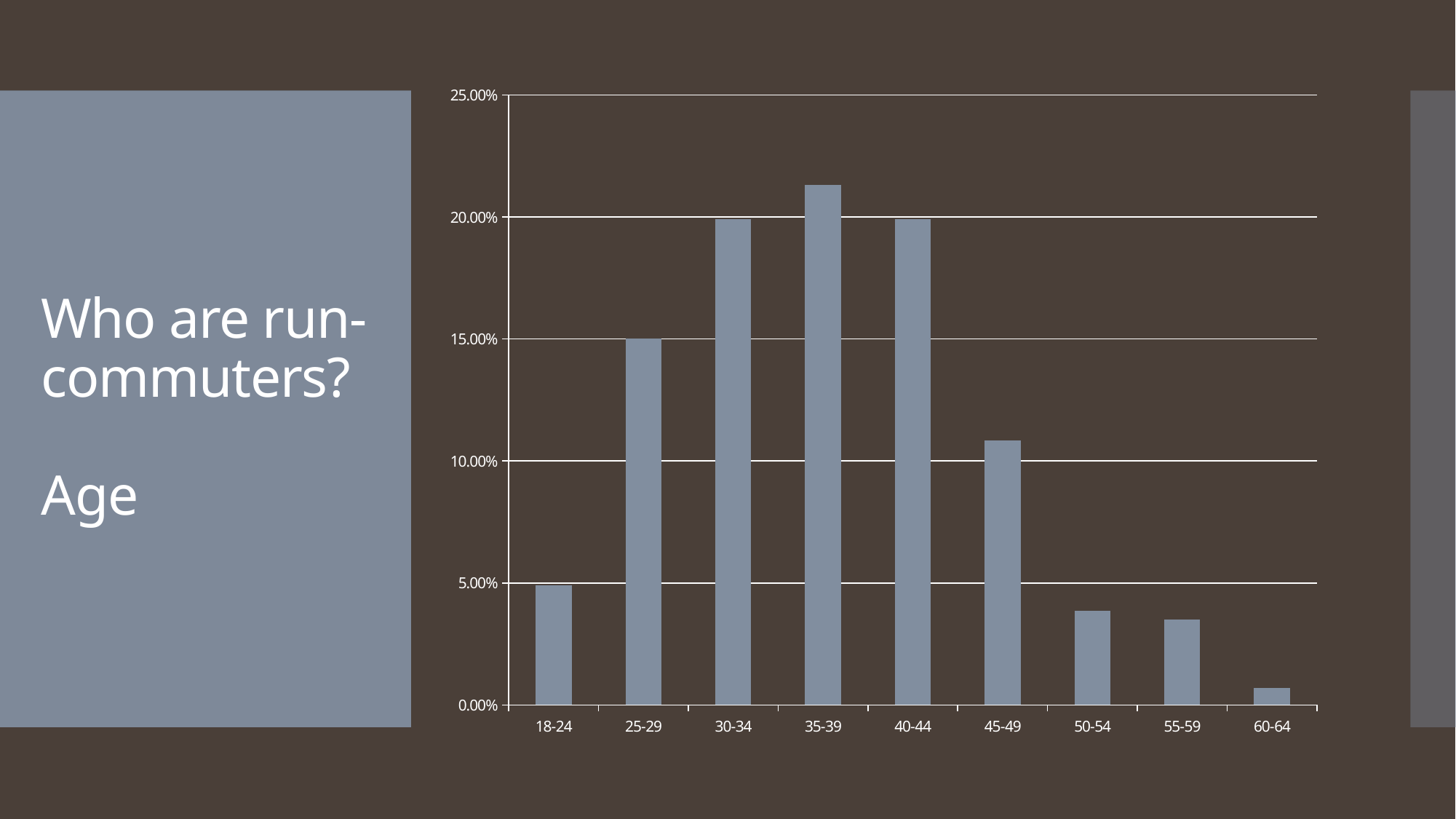
Is the value for 45-49 greater or less than 10.00%? greater Which age group has the highest value? 35-39 Is the value for 35-39 greater or less than 20.00%? greater Which is larger, the value for 18-24 or the value for 25-29? 25-29 What kind of chart is shown on the slide? bar chart Which age group has the lowest value? 60-64 Is the value for 50-54 greater or less than 5.00%? less Do the values rise or fall from 40-44 to 60-64 along the x axis? fall Which is larger, the value for 35-39 or the value for 45-49? 35-39 How many age categories are shown on the x axis? 9 What is the highest value shown on the y axis? 25.00%